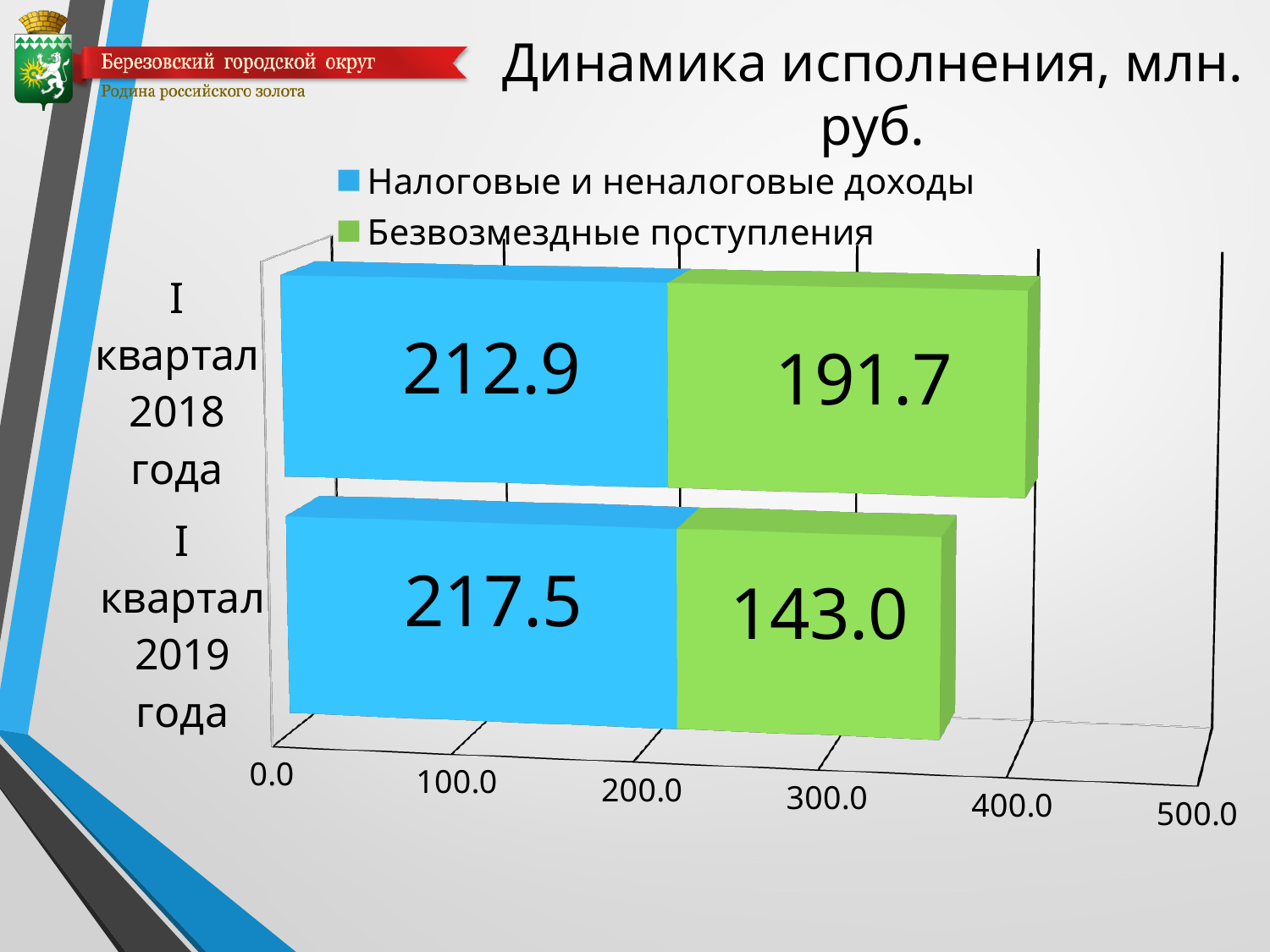
What is the total of the stacked bar for I квартал 2019 года? 360.5 How many categories are shown on the chart? 2 Which is larger: Безвозмездные поступления in I квартал 2018 года or in I квартал 2019 года? I квартал 2018 года What is the value of Безвозмездные поступления for I квартал 2018 года? 191.7 What is the difference between Безвозмездные поступления in I квартал 2018 года and I квартал 2019 года? 48.7 In which period is Безвозмездные поступления lowest? I квартал 2019 года What is the value of Налоговые и неналоговые доходы for I квартал 2019 года? 217.5 What is the total of the stacked bar for I квартал 2018 года? 404.6 How many series does the legend list? 2 What is the value of Безвозмездные поступления for I квартал 2019 года? 143.0 What is the value of Налоговые и неналоговые доходы for I квартал 2018 года? 212.9 What kind of chart is shown on the slide? Stacked bar chart